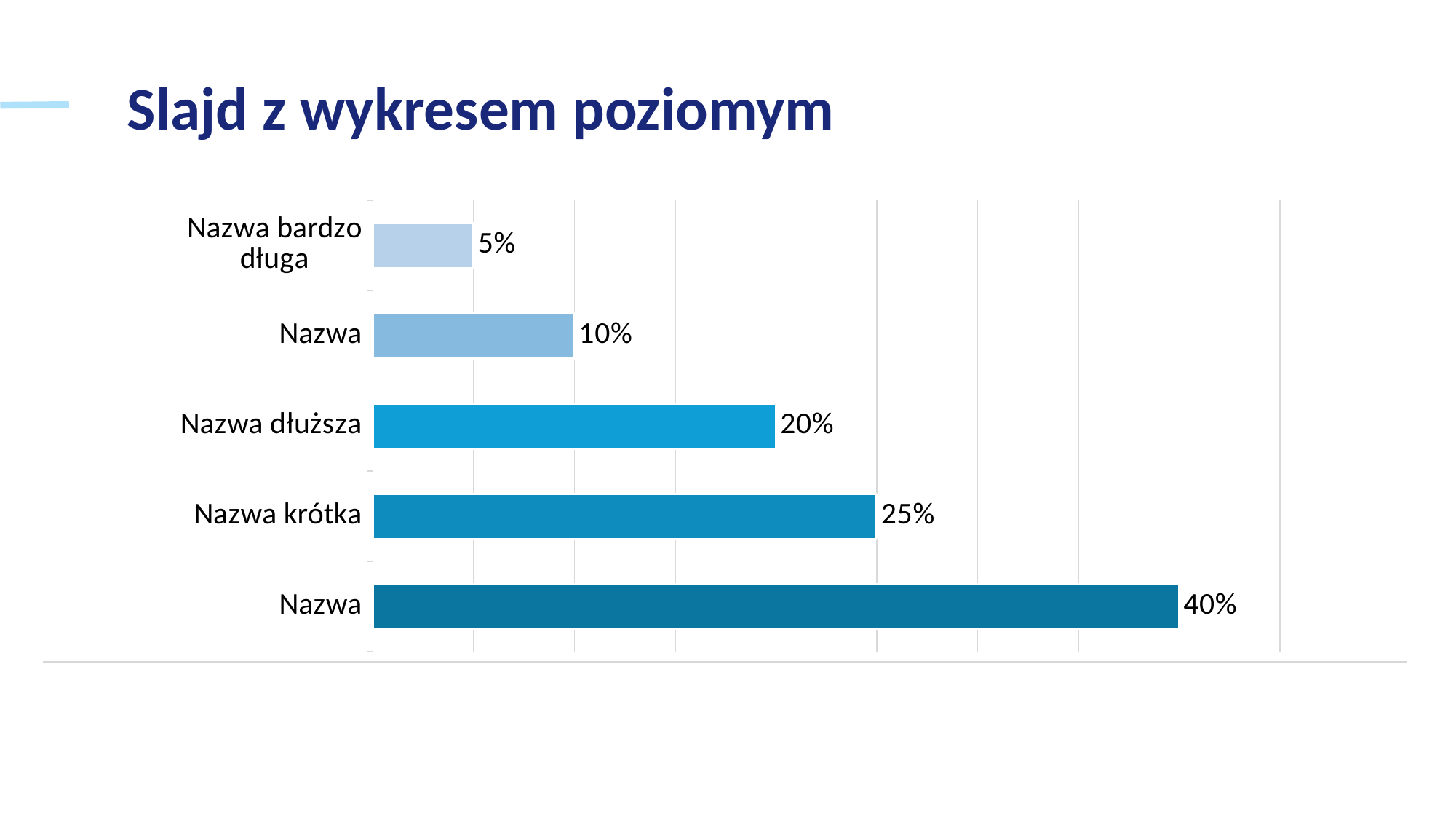
What is the difference between the bottom bar (40%) and the value for "Nazwa bardzo długa"? 35% Which is larger, the value for "Nazwa krótka" or the value for "Nazwa dłuższa"? Nazwa krótka What kind of chart is shown on the slide? Bar chart What is the value of the bottom bar, labelled "Nazwa"? 40% Which category has the lowest value? Nazwa bardzo długa What is the value for "Nazwa bardzo długa"? 5% What is the difference between the values for "Nazwa krótka" and "Nazwa dłuższa"? 5% What is the highest value shown in the chart? 40% What is the value for "Nazwa krótka"? 25% What is the value for "Nazwa dłuższa"? 20% How many bars are in the chart? 5 What is the value of the second bar from the top, labelled "Nazwa"? 10%